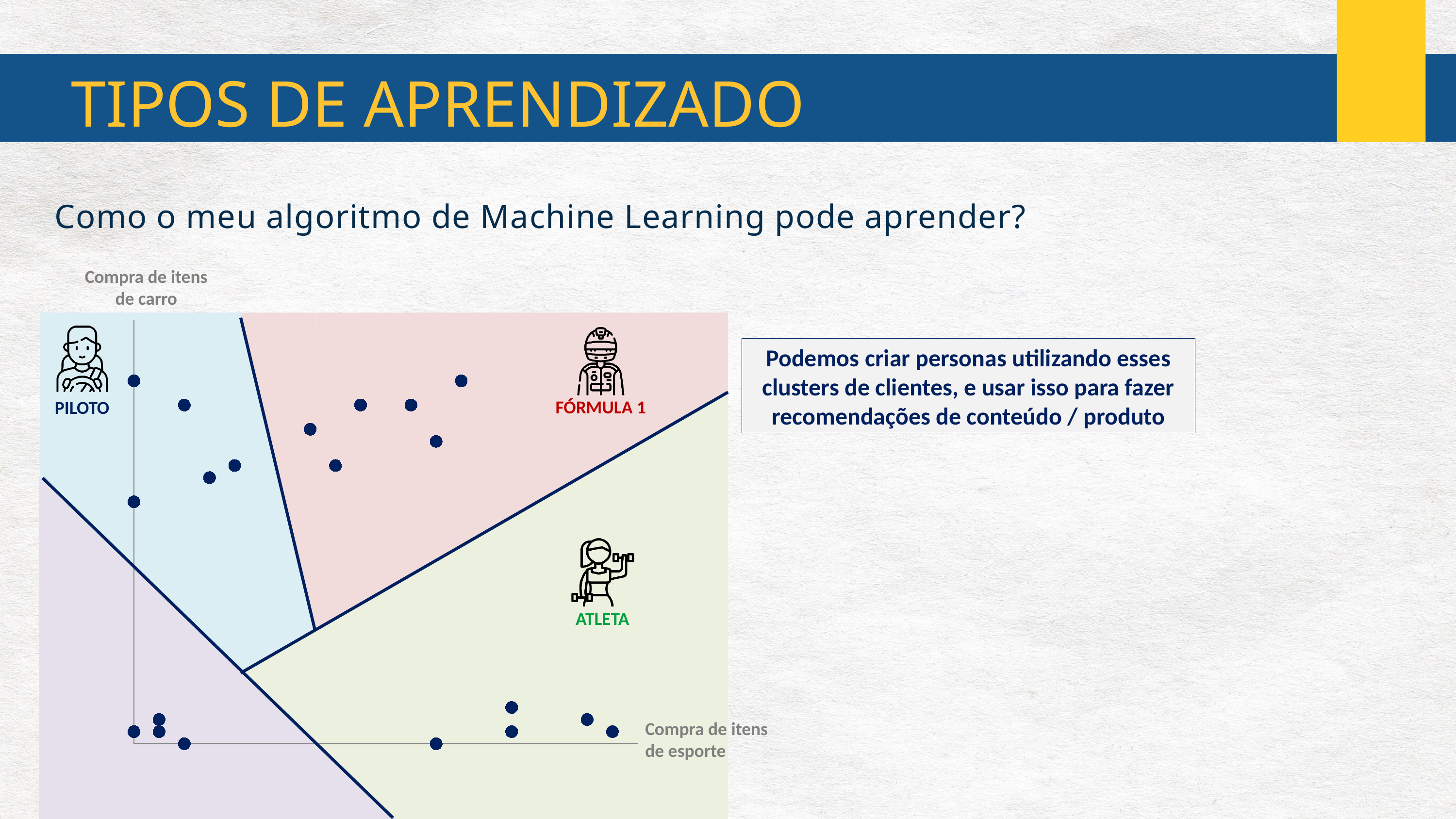
Which labeled cluster has its points furthest to the right along the 'Compra de itens de esporte' axis? ATLETA How many coloured regions is the chart divided into? 4 How many named clusters (personas) are labeled on the chart? 3 Which cluster label is shown in the pink region of the chart? FÓRMULA 1 How many data points are plotted in the ATLETA (green) region? 5 What is the label of the horizontal axis of the chart? Compra de itens de esporte Which labeled cluster has its points lowest on the 'Compra de itens de carro' axis? ATLETA Which cluster label is shown in the light blue region of the chart? PILOTO Which cluster label is shown in the green region of the chart? ATLETA What kind of chart is shown on the slide? Scatter plot What is the label of the vertical axis of the chart? Compra de itens de carro